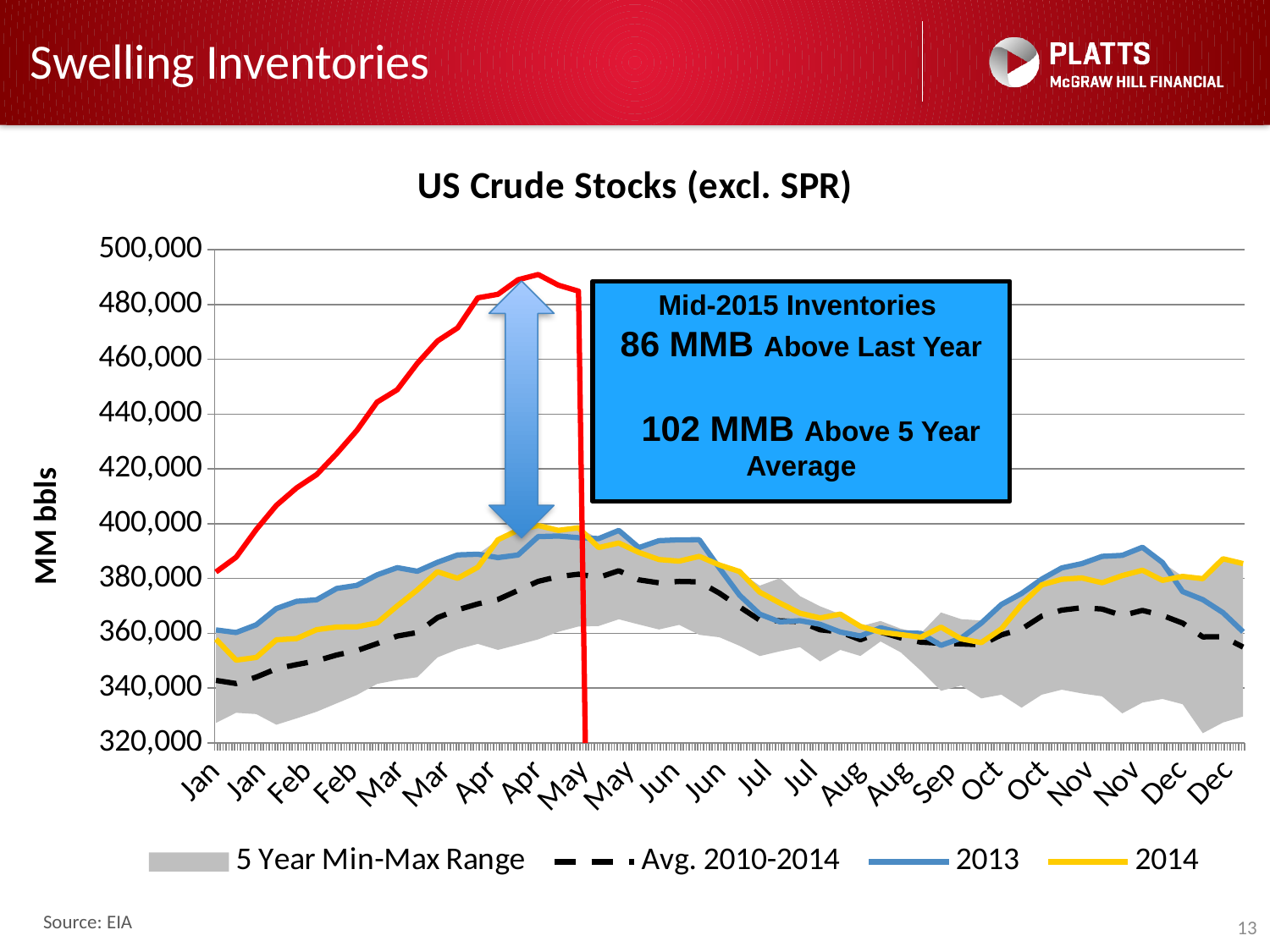
What is the title of the chart? US Crude Stocks (excl. SPR) Does the 2014 series rise or fall from Jan to Apr? rise How many labels are shown along the x axis? 23 Does the Avg. 2010-2014 series rise or fall from Jan to May? rise What kind of chart is shown on the slide? combination area and line chart How many series does the legend list? 4 Is the value of the 2014 series at the first May label greater or less than 380,000? greater Is the value of the Avg. 2010-2014 series at the first Jan label greater or less than 360,000? less Is the value of the 2013 series at the last Dec label greater or less than 380,000? less Does the 2013 series rise or fall from Jun to Sep? fall According to the text box on the chart, how far above the 5 year average were mid-2015 inventories? 102 MMB